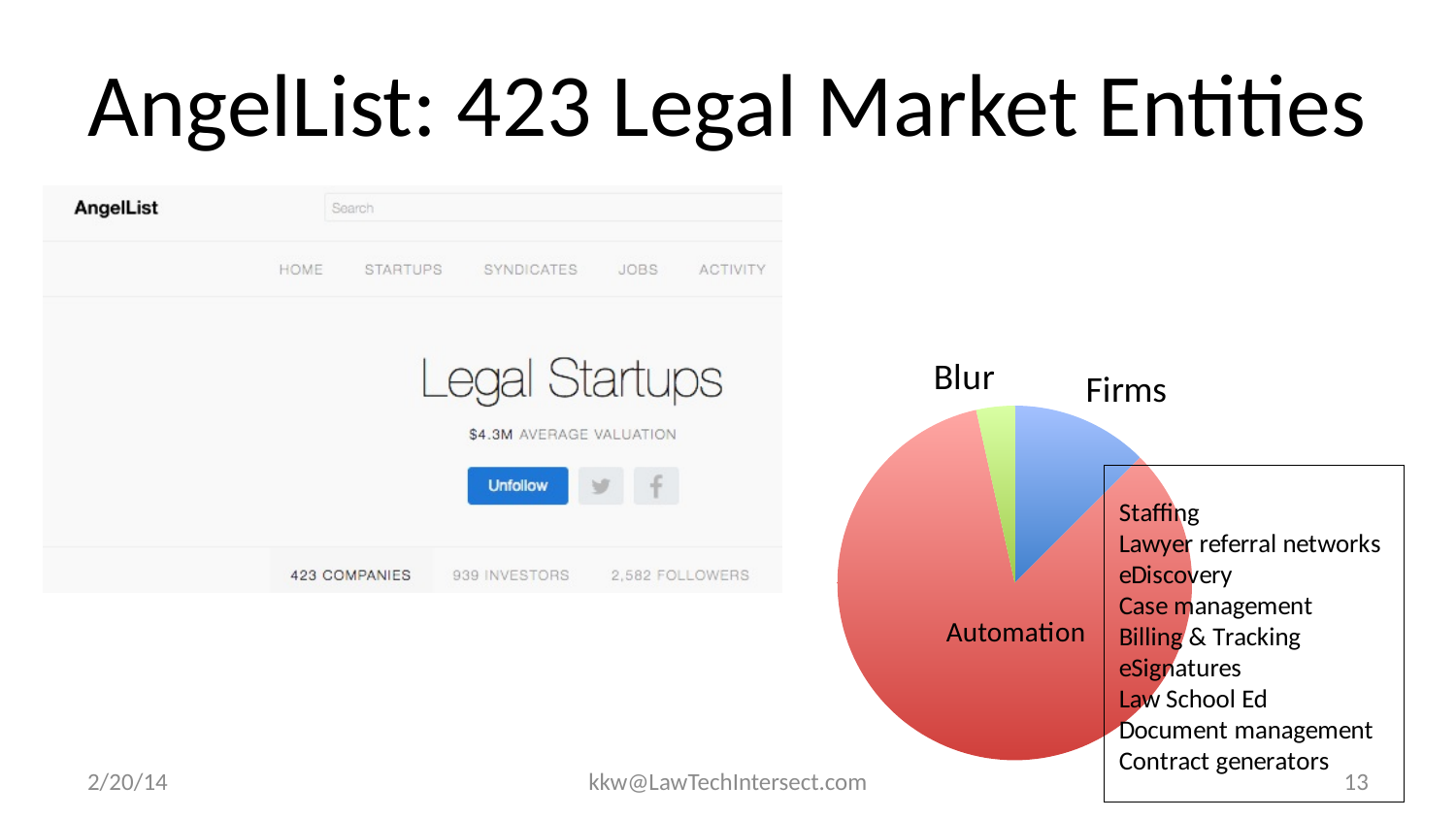
What colour is the Firms slice in the pie chart? blue How many slices does the pie chart have? 3 What kind of chart is shown on the right side of the slide? pie chart In the pie chart, which is larger: the Firms slice or the Blur slice? Firms What colour is the Automation slice in the pie chart? red Does the Automation slice take up more or less than half of the pie chart? more In the pie chart, which is larger: the Automation slice or the Firms slice? Automation Which slice of the pie chart is the smallest? Blur Which slice of the pie chart is the largest? Automation